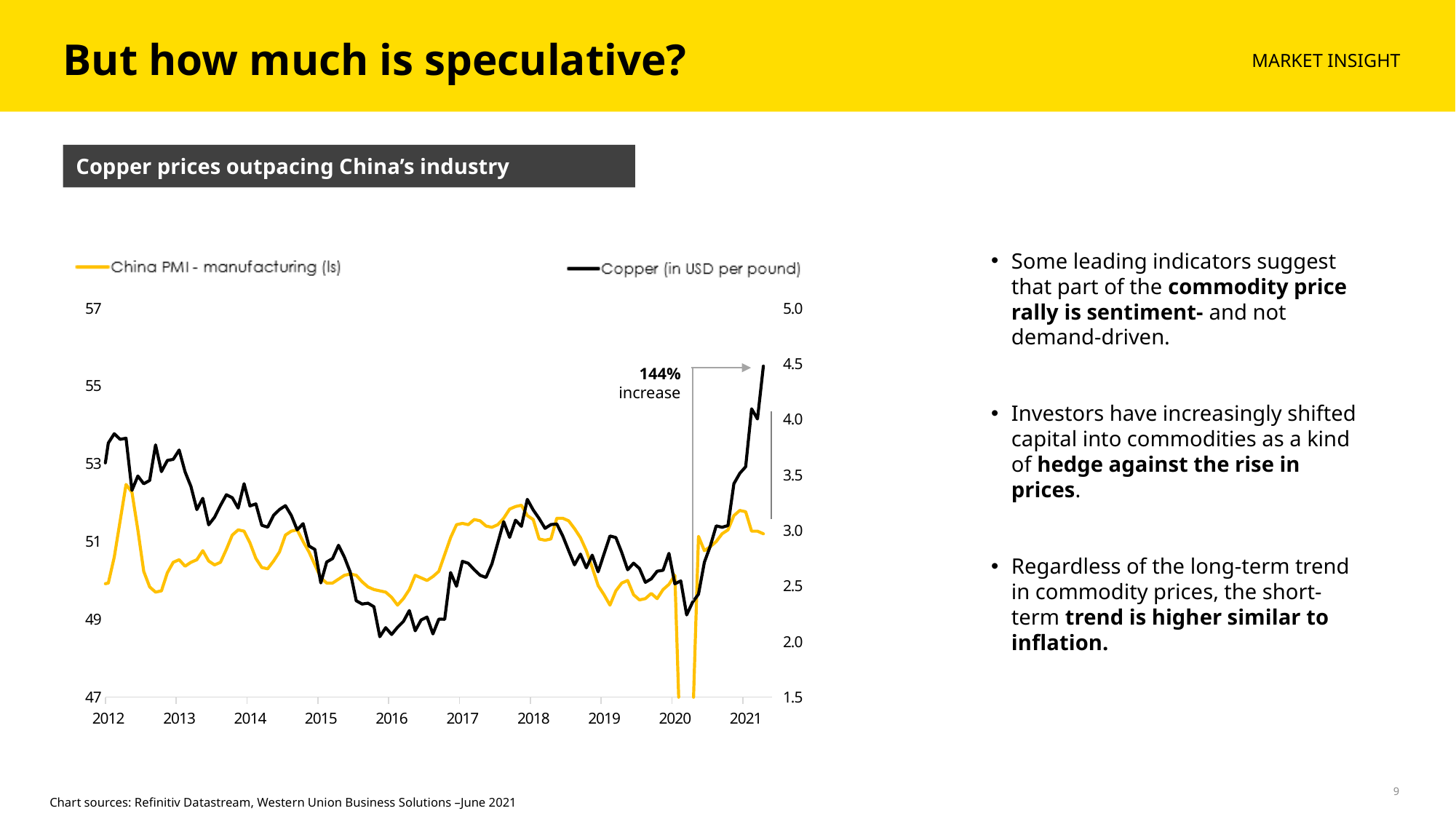
Is the value for Copper (in USD per pound) at the start of 2012 greater or less than 3.5? greater Which series is plotted in black? Copper (in USD per pound) Is the lowest value for China PMI - manufacturing (ls) in early 2020 greater or less than 49? less How many year labels are shown on the x axis? 10 How many series does the chart legend list? 2 Is the value for Copper (in USD per pound) at the end of the series in 2021 greater or less than 4.0? greater What percentage increase is annotated on the chart for copper? 144% Does the Copper (in USD per pound) series rise or fall between 2020 and 2021? rise What is the title of the chart? Copper prices outpacing China's industry Does the Copper (in USD per pound) series rise or fall between 2012 and 2016? fall What kind of chart is shown on the slide? Line chart